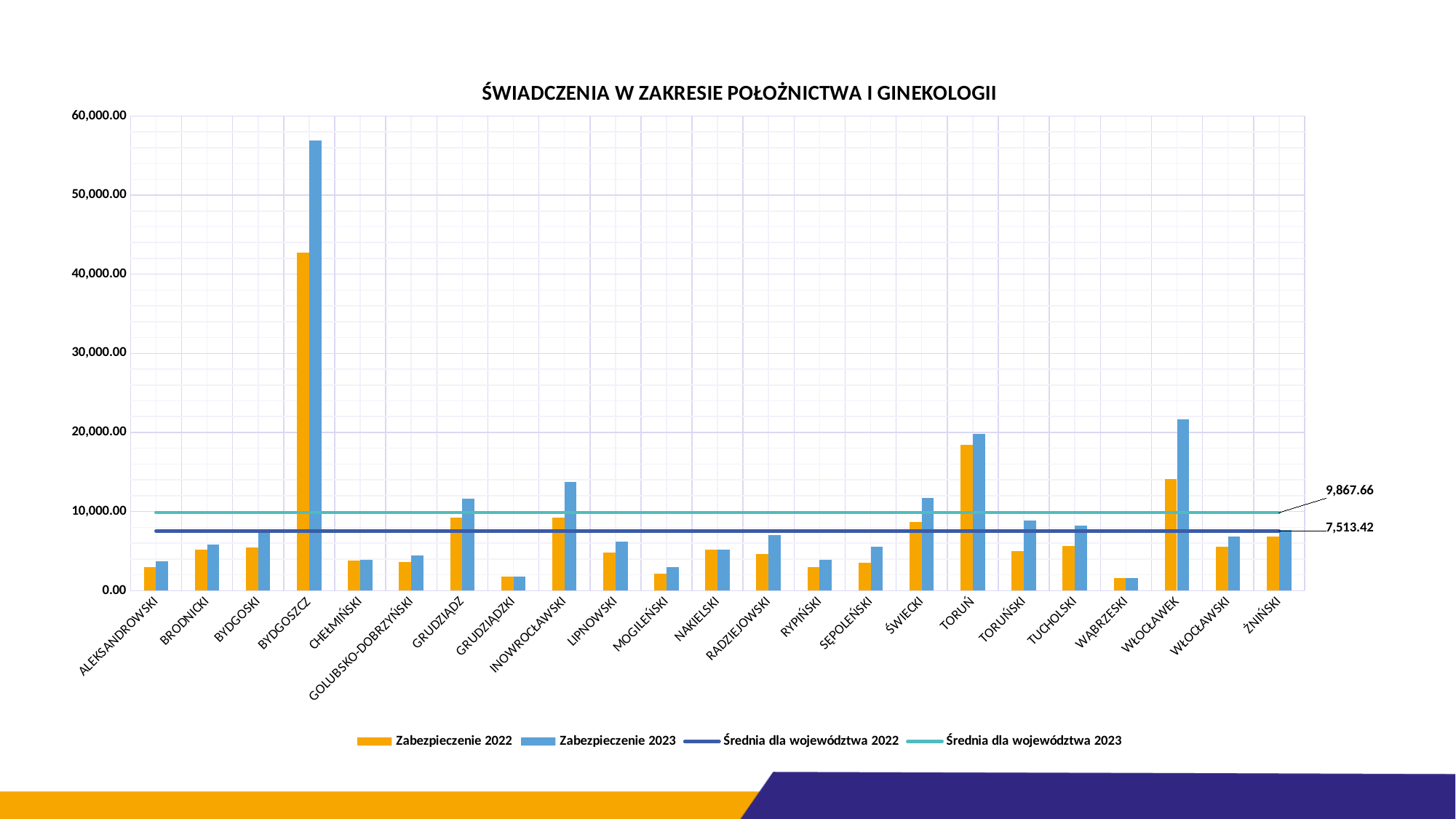
Which has the larger Zabezpieczenie 2022 value: TORUŃ or WŁOCŁAWEK? TORUŃ Is the Zabezpieczenie 2023 value for BYDGOSZCZ greater or less than 50,000.00? greater Is the Zabezpieczenie 2022 value for TORUŃ greater or less than 20,000.00? less How many entries does the legend list? 4 What is the value of the line Średnia dla województwa 2023? 9,867.66 What is the difference between Średnia dla województwa 2023 and Średnia dla województwa 2022? 2,354.25 For WŁOCŁAWEK, which is larger: Zabezpieczenie 2022 or Zabezpieczenie 2023? Zabezpieczenie 2023 How many categories (powiaty/cities) are shown on the x axis? 23 What is the value of the line Średnia dla województwa 2022? 7,513.42 Which category has the highest value for Zabezpieczenie 2023? BYDGOSZCZ What is the title of the chart? ŚWIADCZENIA W ZAKRESIE POŁOŻNICTWA I GINEKOLOGII What kind of chart is shown on the slide? combination bar and line chart